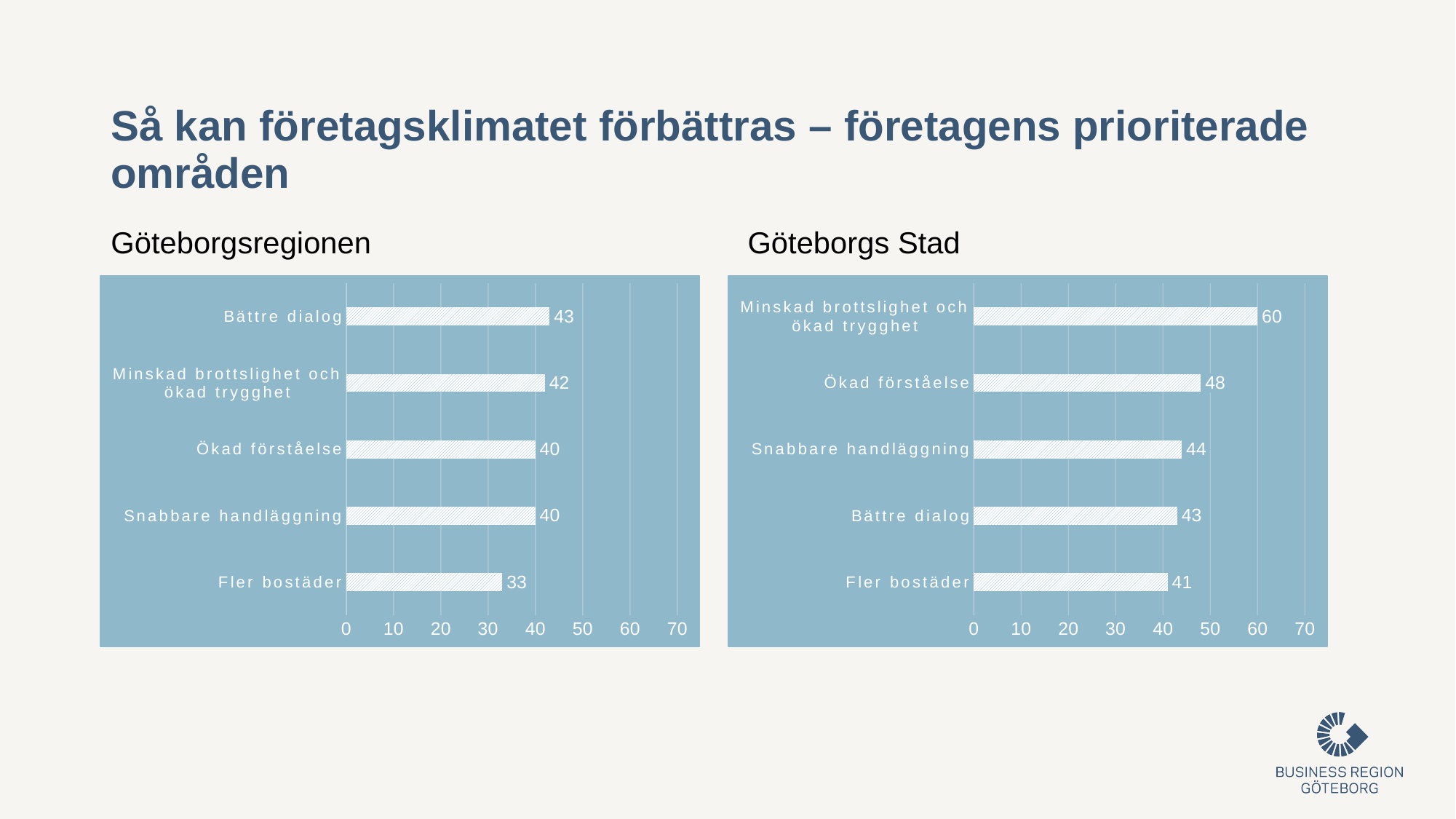
In the Göteborgs Stad chart, what is the value for Snabbare handläggning? 44 In the Göteborgsregionen chart, what is the value for Fler bostäder? 33 What type of chart is the Göteborgs Stad chart? Bar chart How many categories does the Göteborgsregionen chart show? 5 In the Göteborgsregionen chart, what is the value for Bättre dialog? 43 In the Göteborgsregionen chart, which category has the highest value? Bättre dialog In the Göteborgs Stad chart, what is the value for Minskad brottslighet och ökad trygghet? 60 In the Göteborgs Stad chart, is the value for Minskad brottslighet och ökad trygghet greater or less than 50? greater In the Göteborgsregionen chart, what is the difference between Bättre dialog and Fler bostäder? 10 In the Göteborgs Stad chart, what is the difference between Minskad brottslighet och ökad trygghet and Ökad förståelse? 12 Which chart shows a larger value for Fler bostäder, Göteborgsregionen or Göteborgs Stad? Göteborgs Stad In the Göteborgs Stad chart, which category has the lowest value? Fler bostäder